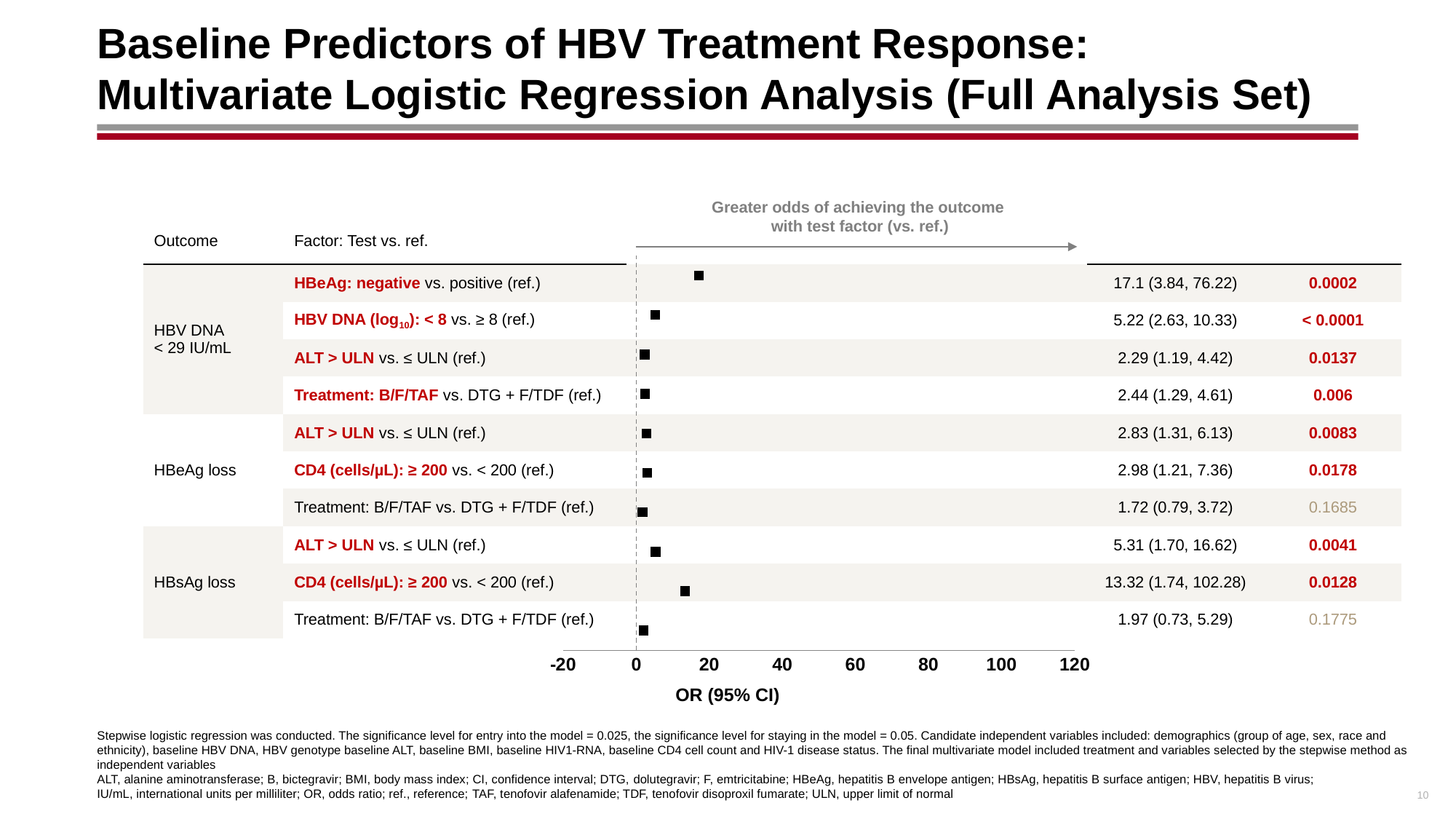
Is the odds ratio for HBeAg: negative vs. positive greater or less than 20? less What is the p-value shown for ALT > ULN vs. ≤ ULN for the HBeAg loss outcome? 0.0083 Which factor has the highest odds ratio on the plot? HBeAg: negative vs. positive (ref.) How many factor rows (points) are plotted on the chart? 10 What is the odds ratio (95% CI) for CD4 (cells/µL) ≥ 200 vs. < 200 for the HBsAg loss outcome? 13.32 (1.74, 102.28) What kind of chart is shown on the slide? Forest plot What is the label of the x axis of the chart? OR (95% CI) What is the odds ratio for HBeAg: negative vs. positive for the HBV DNA < 29 IU/mL outcome? 17.1 Which factor has the lowest odds ratio on the plot? Treatment: B/F/TAF vs. DTG + F/TDF (ref.) for HBeAg loss What is the odds ratio for Treatment: B/F/TAF vs. DTG + F/TDF for the HBeAg loss outcome? 1.72 What is the difference between the odds ratio for HBeAg: negative vs. positive (17.1) and the odds ratio for CD4 ≥ 200 vs. < 200 for HBsAg loss (13.32)? 3.78 Which has the larger odds ratio: ALT > ULN vs. ≤ ULN for HBsAg loss, or ALT > ULN vs. ≤ ULN for HBV DNA < 29 IU/mL? ALT > ULN vs. ≤ ULN for HBsAg loss